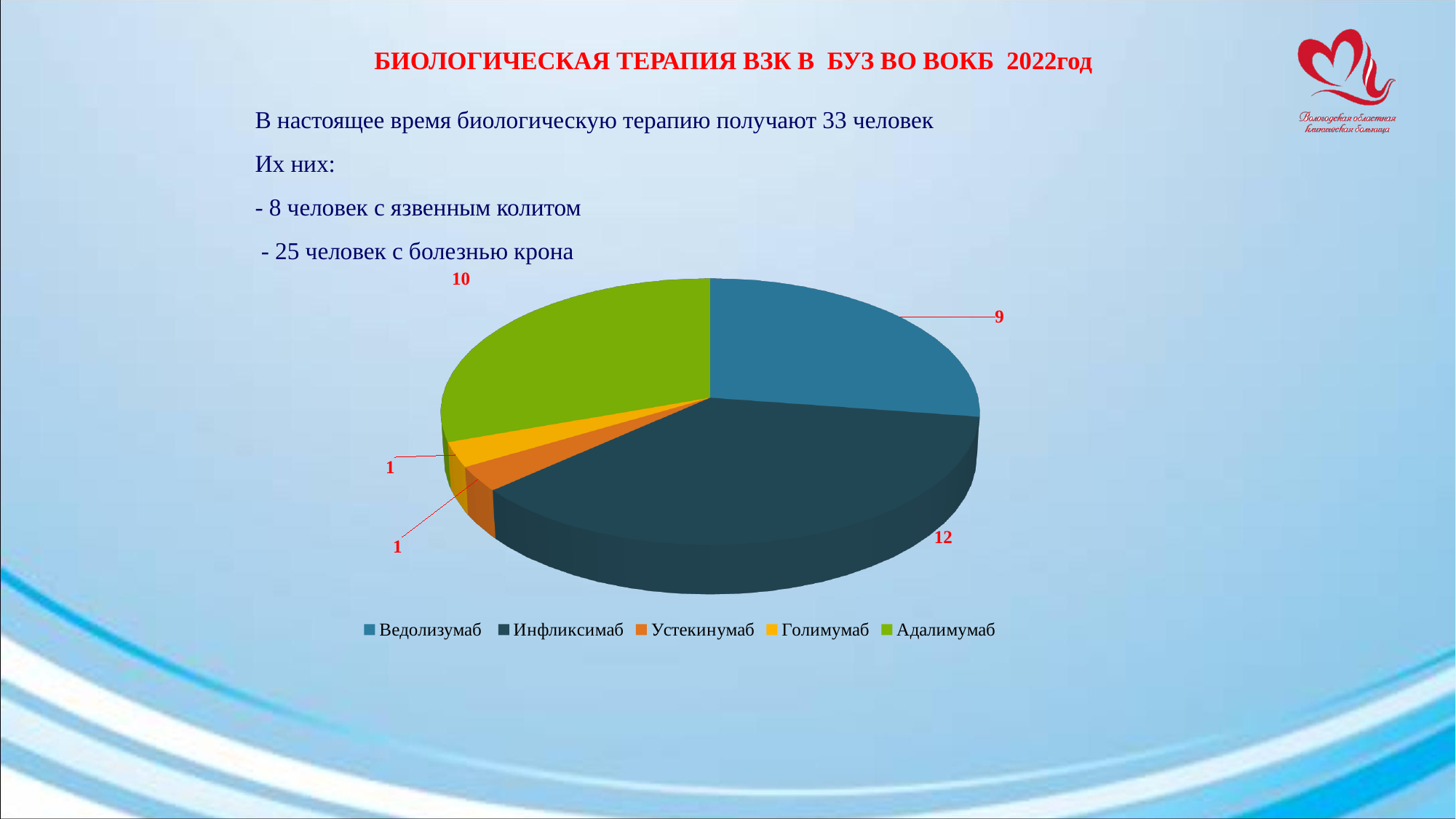
What is the difference between the values for Инфликсимаб and Ведолизумаб? 3 What is the value for Ведолизумаб in the pie chart? 9 What colour is the Адалимумаб slice in the pie chart? green Which is larger, the value for Адалимумаб or the value for Ведолизумаб? Адалимумаб What is the value for Адалимумаб in the pie chart? 10 What is the total of all the values shown in the pie chart? 33 What is the value for Голимумаб in the pie chart? 1 How many categories does the pie chart show? 5 Which category has the largest slice in the pie chart? Инфликсимаб How many slices in the pie chart have a value of 1? 2 What kind of chart is shown on the slide? pie chart What is the value for Инфликсимаб in the pie chart? 12